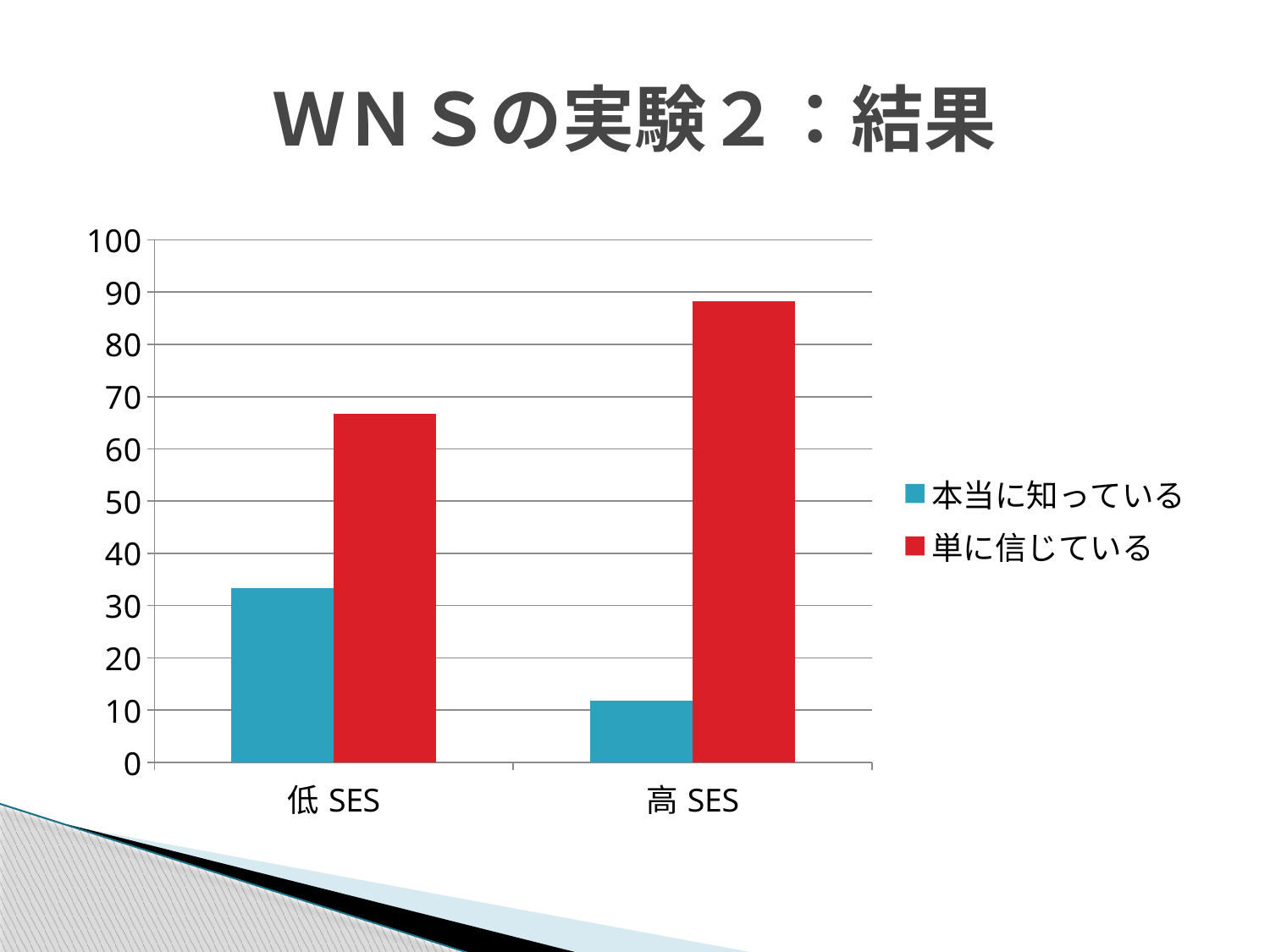
How many series does the legend list? 2 Which group has the higher value for 単に信じている, 低 SES or 高 SES? 高 SES Is the value for 単に信じている in the 低 SES group greater or less than 60? greater Is the value for 本当に知っている in the 高 SES group greater or less than 20? less Is the value for 本当に知っている in the 低 SES group greater or less than 40? less Which bar is the tallest in the chart? 単に信じている for 高 SES What is the title of the slide containing the chart? WNSの実験2：結果 Which group has the lower value for 本当に知っている, 低 SES or 高 SES? 高 SES How many categories are shown on the x axis? 2 Which series is shown in red in the legend? 単に信じている What kind of chart is shown on the slide? bar chart